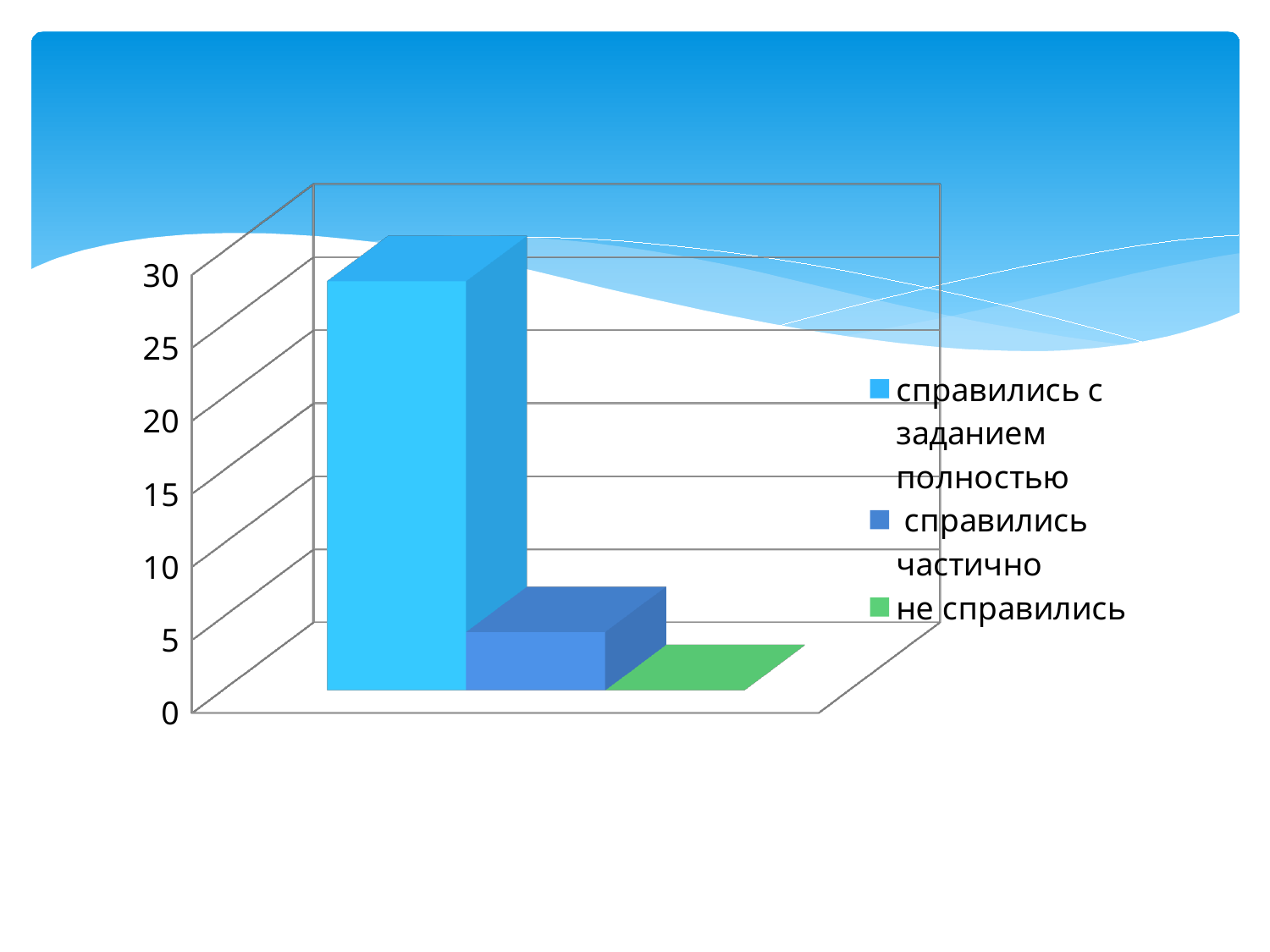
Which series has the lowest value? не справились Which is larger: the value for "справились частично" or the value for "не справились"? справились частично How many series does the legend list? 3 Is the value for "справились с заданием полностью" greater or less than 25? greater What is the highest value shown on the vertical axis? 30 What kind of chart is shown on the slide? bar chart Is the value for "справились частично" greater or less than 10? less Which series has the highest value? справились с заданием полностью Is the value for "не справились" greater or less than 5? less Which is larger: the value for "справились с заданием полностью" or the value for "справились частично"? справились с заданием полностью What colour is the bar for "не справились"? green